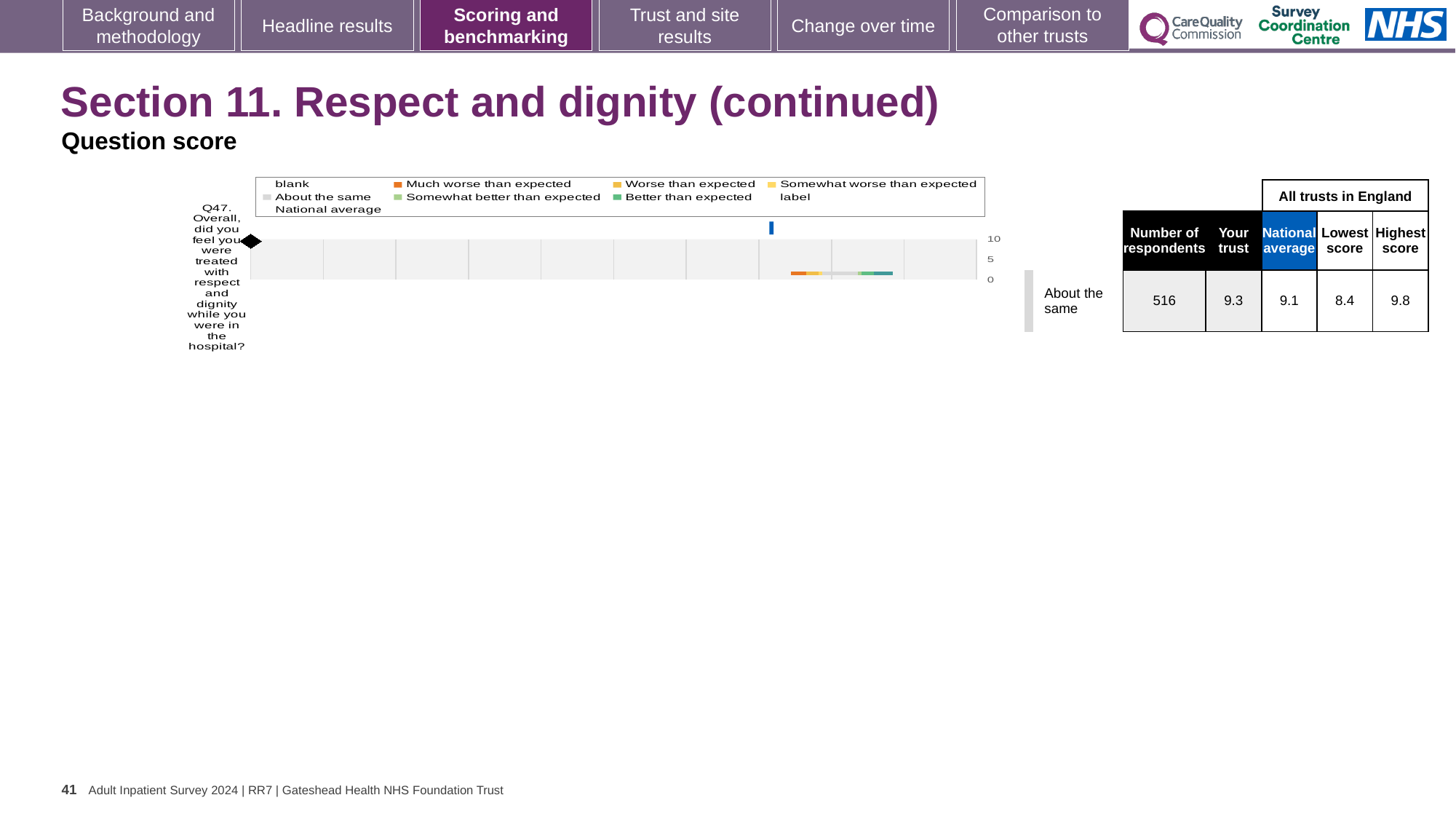
What is the lowest score among all trusts in England for Q47? 8.4 What benchmarking category is the trust's Q47 result placed in? About the same What is the difference between the highest and lowest scores among all trusts in England for Q47? 1.4 What is the national average score for Q47 shown in the table? 9.1 What is the maximum value shown on the chart's axis? 10 What is the 'Your trust' score for Q47 shown in the table? 9.3 What is the highest score among all trusts in England for Q47? 9.8 Which legend entry is shown in orange? Much worse than expected How many respondents answered Q47? 516 What is the difference between the trust's score and the national average for Q47? 0.2 Is the trust's score for Q47 higher or lower than the national average? higher Is the trust's score for Q47 greater or less than 5 on the chart axis? greater